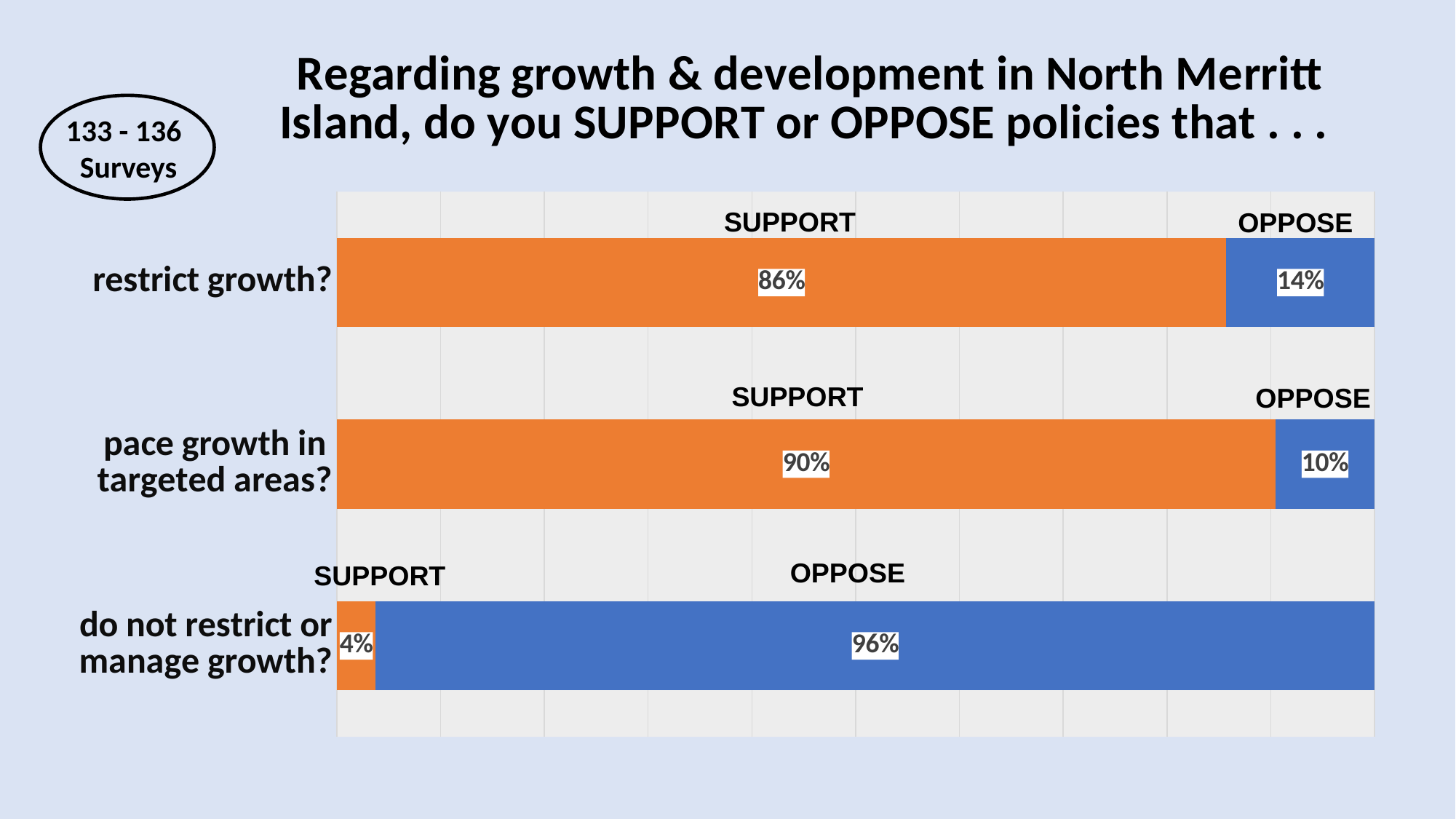
What percentage of respondents oppose policies that do not restrict or manage growth? 96% What percentage of respondents support policies that pace growth in targeted areas? 90% How many policy categories are shown in the chart? 3 What percentage of respondents oppose policies that restrict growth? 14% What percentage of respondents support policies that restrict growth? 86% What is the difference between the support percentages for 'pace growth in targeted areas?' and 'restrict growth?'? 4% Is the oppose percentage higher for 'restrict growth?' or for 'pace growth in targeted areas?'? restrict growth? What type of chart is shown on the slide? bar chart What colour represents the OPPOSE responses in the chart? blue What percentage of respondents support policies that do not restrict or manage growth? 4% Which policy has the lowest support percentage? do not restrict or manage growth? Which policy has the highest support percentage? pace growth in targeted areas?